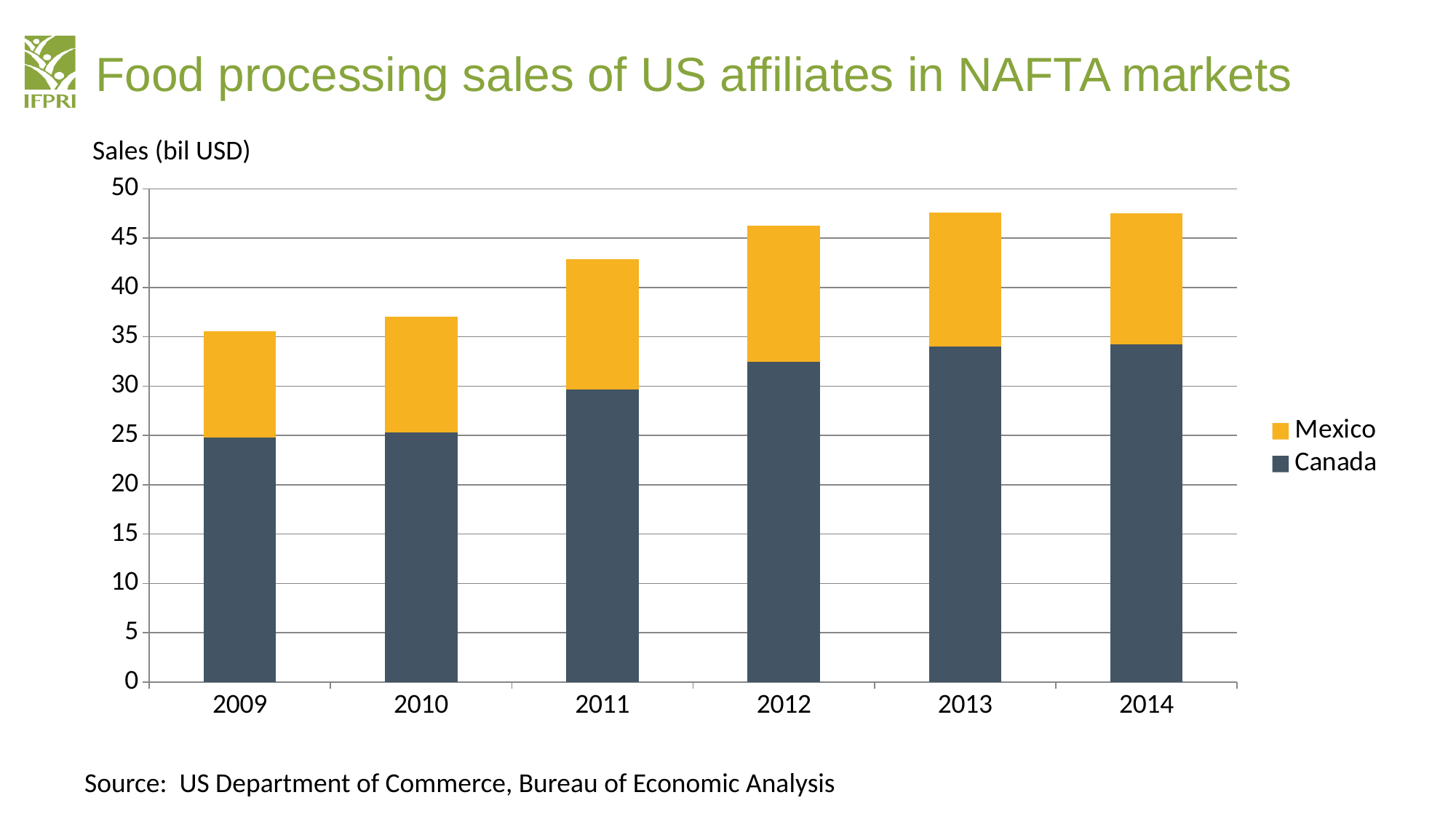
Do the Canada values generally rise or fall from 2009 to 2014? rise How many series does the legend list? 2 Is the total sales value for 2011 greater or less than 40? greater Which colour represents Mexico in the chart? Yellow/orange Which year has the smallest Mexico segment? 2009 How many years are shown on the x axis? 6 Is the total sales value for 2013 greater or less than 45? greater What kind of chart is shown on the slide? Stacked bar chart Which year has the lowest total sales? 2009 Which is larger, the Canada value for 2011 or the Canada value for 2009? 2011 Is the Canada value for 2012 greater or less than 30? greater